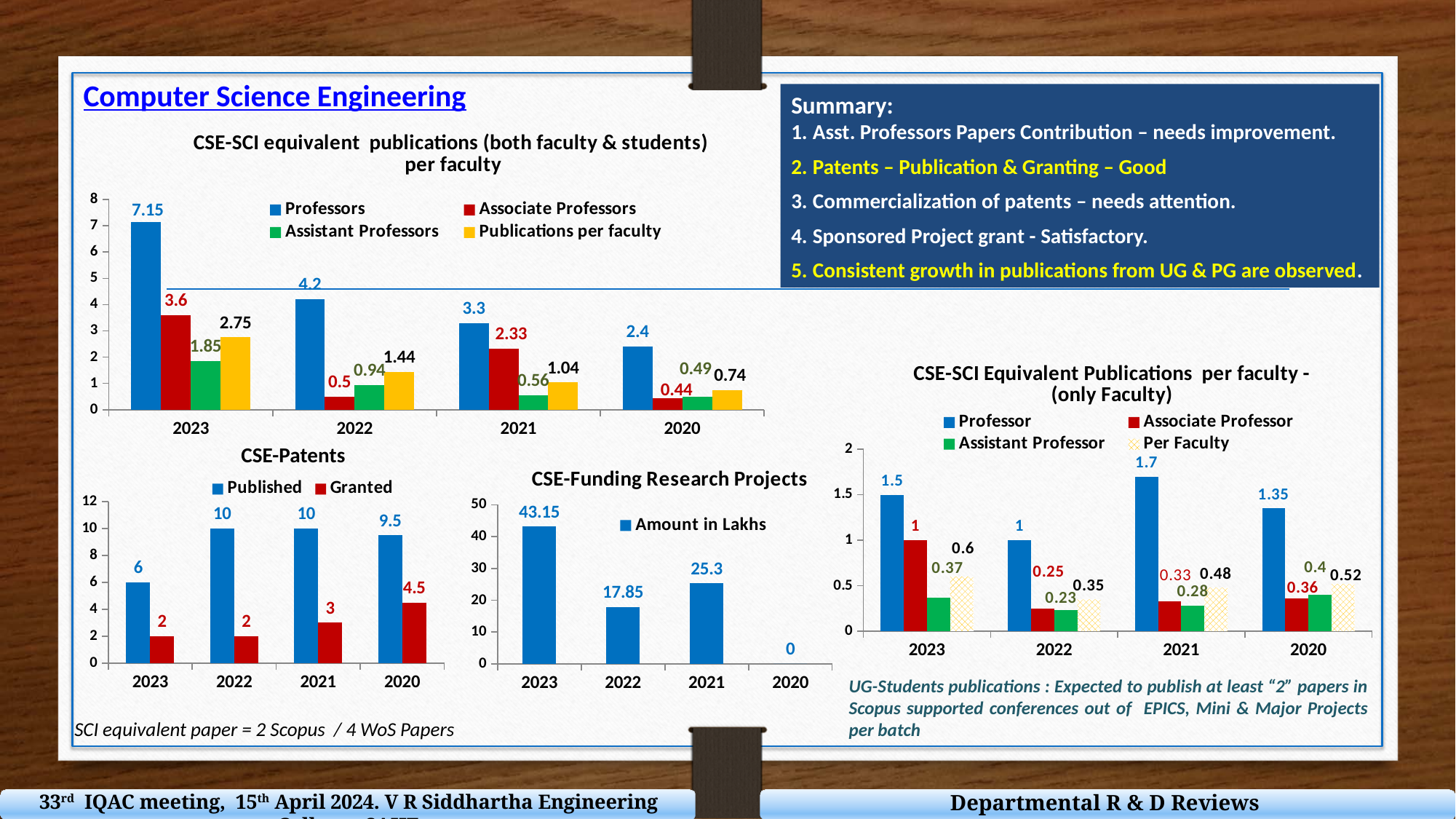
In the CSE-Funding Research Projects chart, how many years are shown on the x axis? 4 In the CSE-Patents chart, what is the difference between Published and Granted in 2022? 8 In the 'CSE-SCI equivalent publications (both faculty & students) per faculty' chart, does the Professors value rise or fall from 2023 to 2020 along the x axis? fall In the 'CSE-SCI equivalent publications (both faculty & students) per faculty' chart, what is the value for Professors in 2023? 7.15 In the CSE-Patents chart, which year has the lowest Published value? 2023 In the CSE-Patents chart, what is the Granted value for 2020? 4.5 In the 'CSE-SCI equivalent publications (both faculty & students) per faculty' chart, what is the difference between the Professors value and the Associate Professors value in 2021? 0.97 What kind of chart is the 'CSE-SCI Equivalent Publications per faculty - (only Faculty)' chart? bar chart In the CSE-Funding Research Projects chart, which year has the highest amount in lakhs? 2023 In the CSE-Funding Research Projects chart, what is the amount in lakhs for 2022? 17.85 In the 'CSE-SCI Equivalent Publications per faculty - (only Faculty)' chart, which year has the highest Professor value? 2021 In the 'CSE-SCI equivalent publications (both faculty & students) per faculty' chart, how many series does the legend list? 4